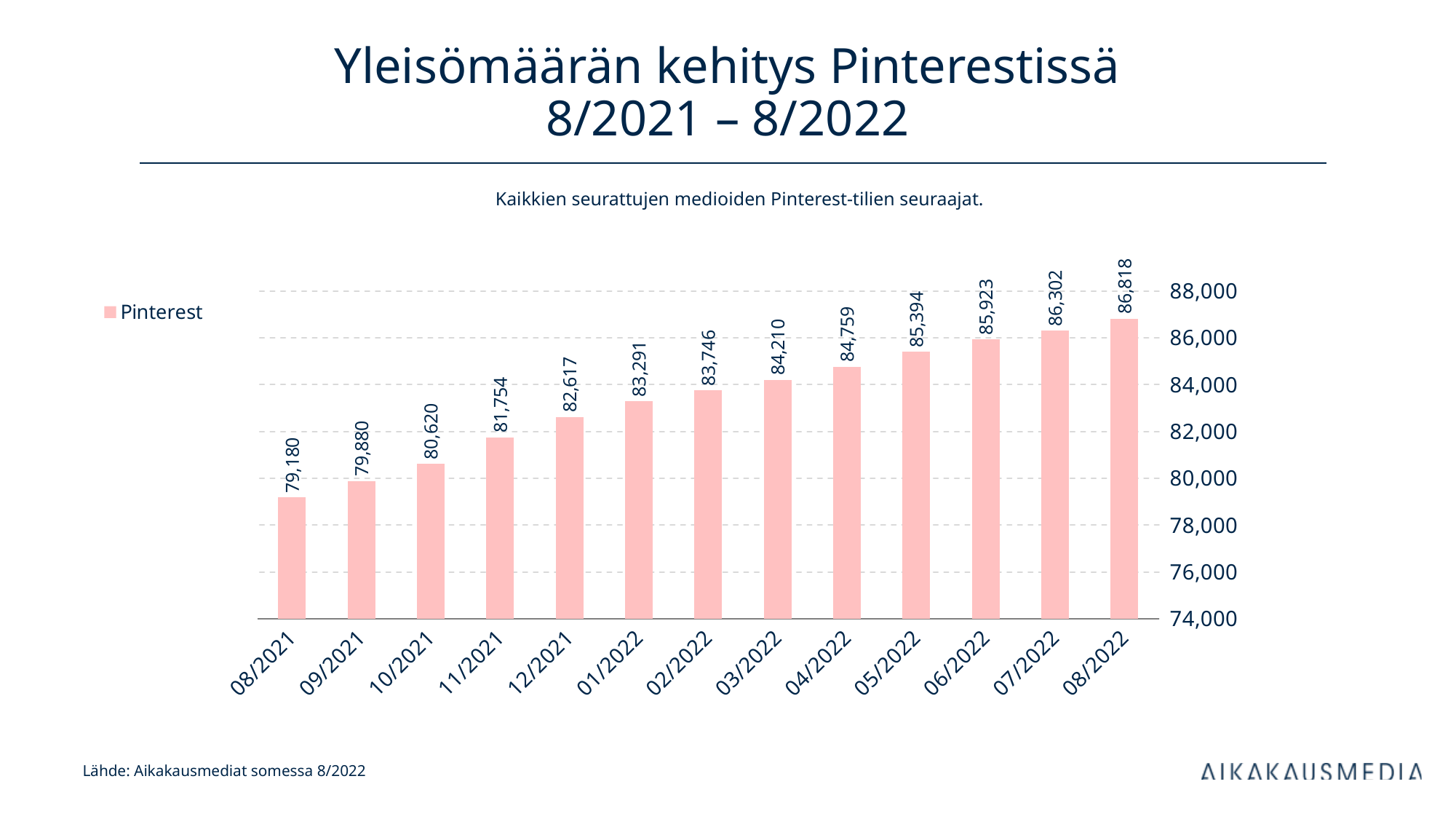
Which is larger, the value for 05/2022 or the value for 02/2022? 05/2022 What is the difference between the values for 08/2022 and 08/2021? 7,638 What is the value for 03/2022? 84,210 How many months are shown on the x axis? 13 What is the value for 08/2022? 86,818 Which month has the highest value? 08/2022 What is the difference between the values for 12/2021 and 11/2021? 863 What kind of chart is shown on the slide? Bar chart Which month has the lowest value? 08/2021 Do the values rise or fall from 08/2021 to 08/2022? Rise Is the value for 10/2021 greater or less than 80,000? greater What is the value for 08/2021? 79,180